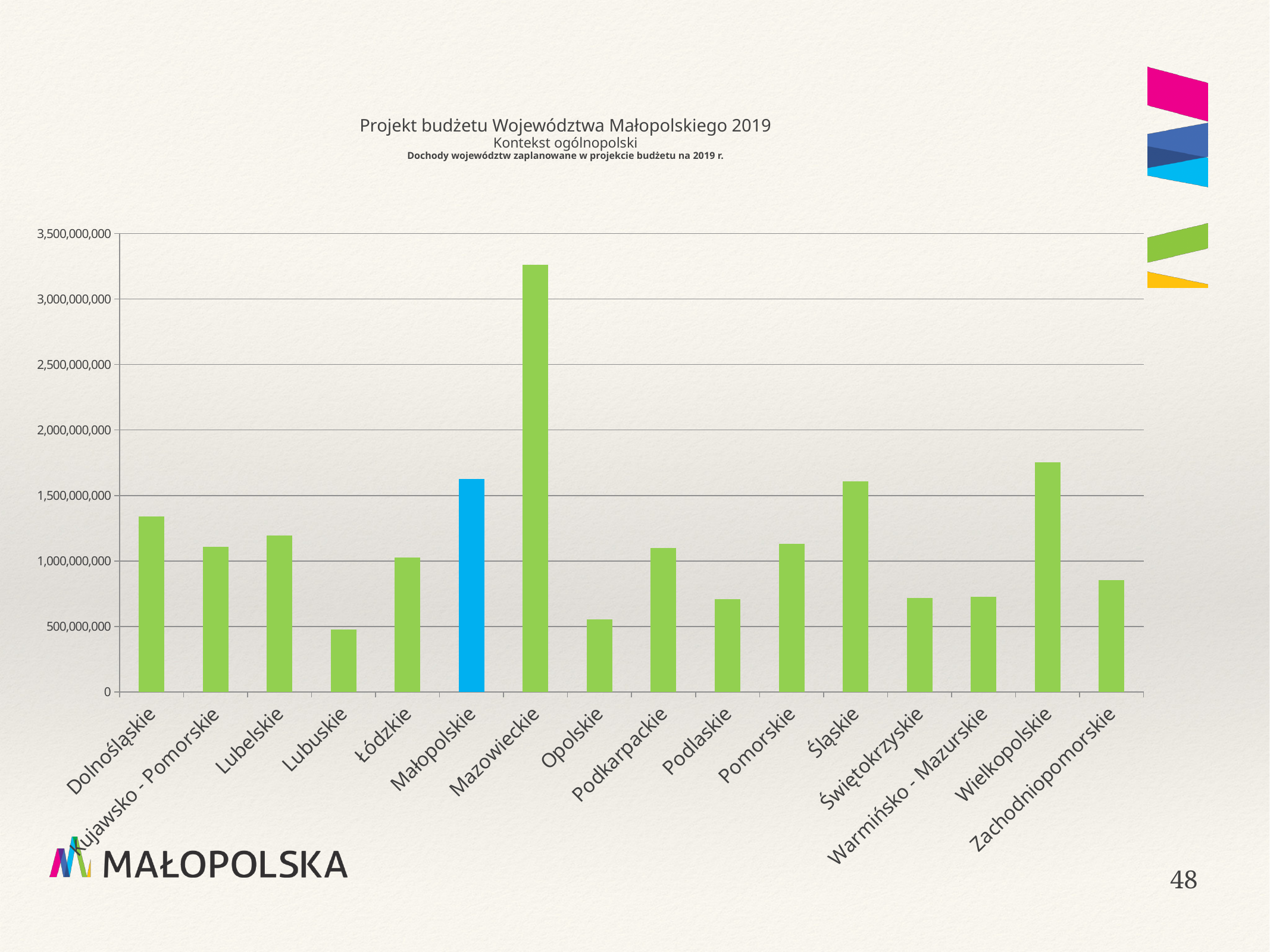
What is the bold subtitle printed above the chart? Dochody województw zaplanowane w projekcie budżetu na 2019 r. Is the value for Małopolskie greater or less than 1,500,000,000? greater What kind of chart is shown on the slide? bar chart Is the value for Mazowieckie greater or less than 3,000,000,000? greater Which voivodeship's bar is coloured blue instead of green? Małopolskie Which is larger, the value for Wielkopolskie or the value for Małopolskie? Wielkopolskie Which voivodeship has the lowest planned income in the chart? Lubuskie Which voivodeship has the highest planned income in the chart? Mazowieckie Which is larger, the value for Dolnośląskie or the value for Opolskie? Dolnośląskie How many voivodeships (categories) are shown on the x axis? 16 Is the value for Zachodniopomorskie greater or less than 1,000,000,000? less